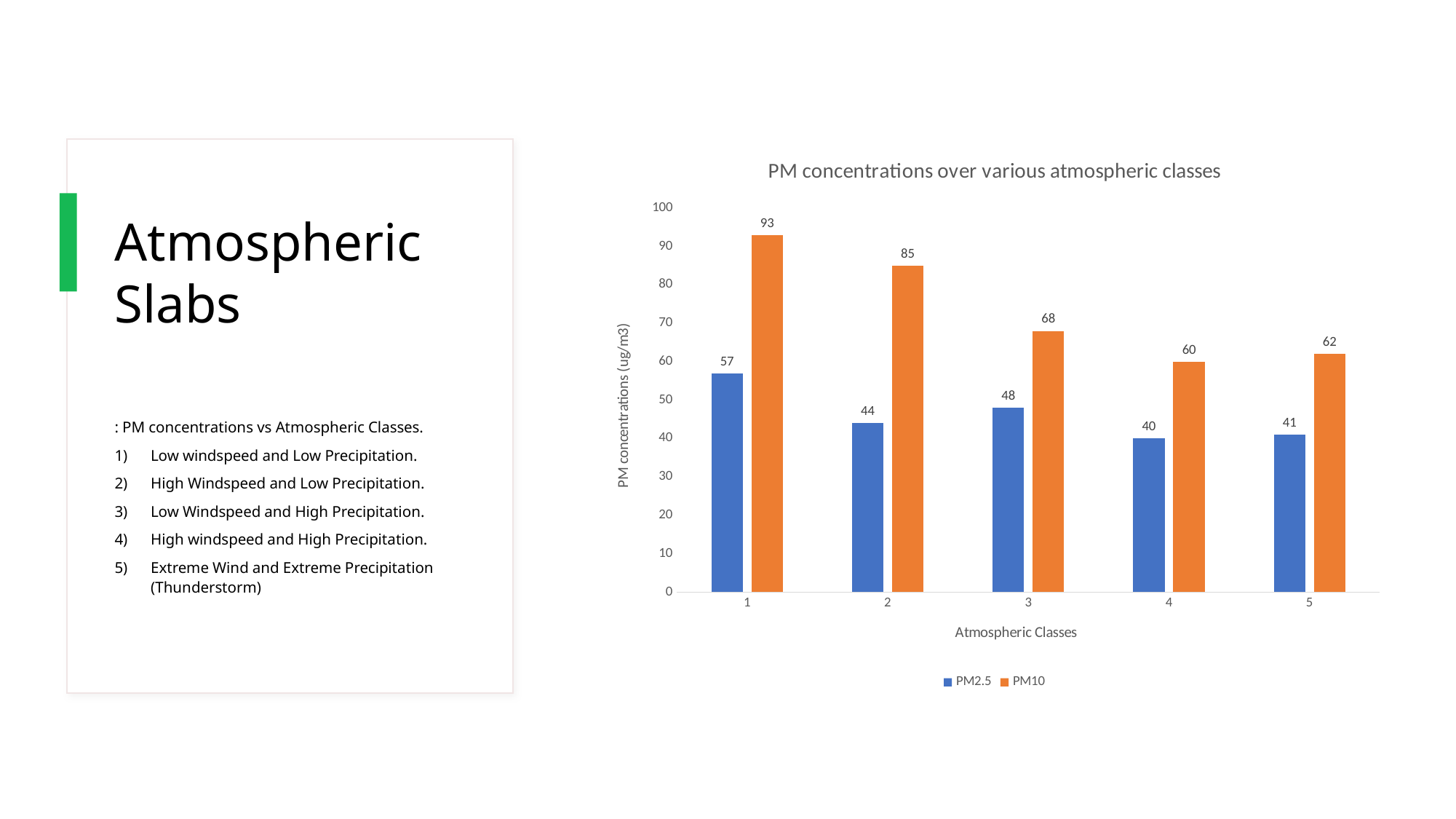
What kind of chart is shown on the slide? bar chart What is the label of the y axis? PM concentrations (ug/m3) Which atmospheric class has the lowest PM10 concentration? 4 What is the title of the chart? PM concentrations over various atmospheric classes How many atmospheric classes are shown on the x axis? 5 How many series does the legend list? 2 What is the PM2.5 concentration for atmospheric class 4? 40 Is the PM10 value for atmospheric class 1 greater or less than 90? greater Which atmospheric class has the highest PM2.5 concentration? 1 What is the difference between the PM10 and PM2.5 concentrations for atmospheric class 2? 41 Which is larger, the PM10 concentration for class 3 or the PM10 concentration for class 5? class 3 What is the PM10 concentration for atmospheric class 1? 93